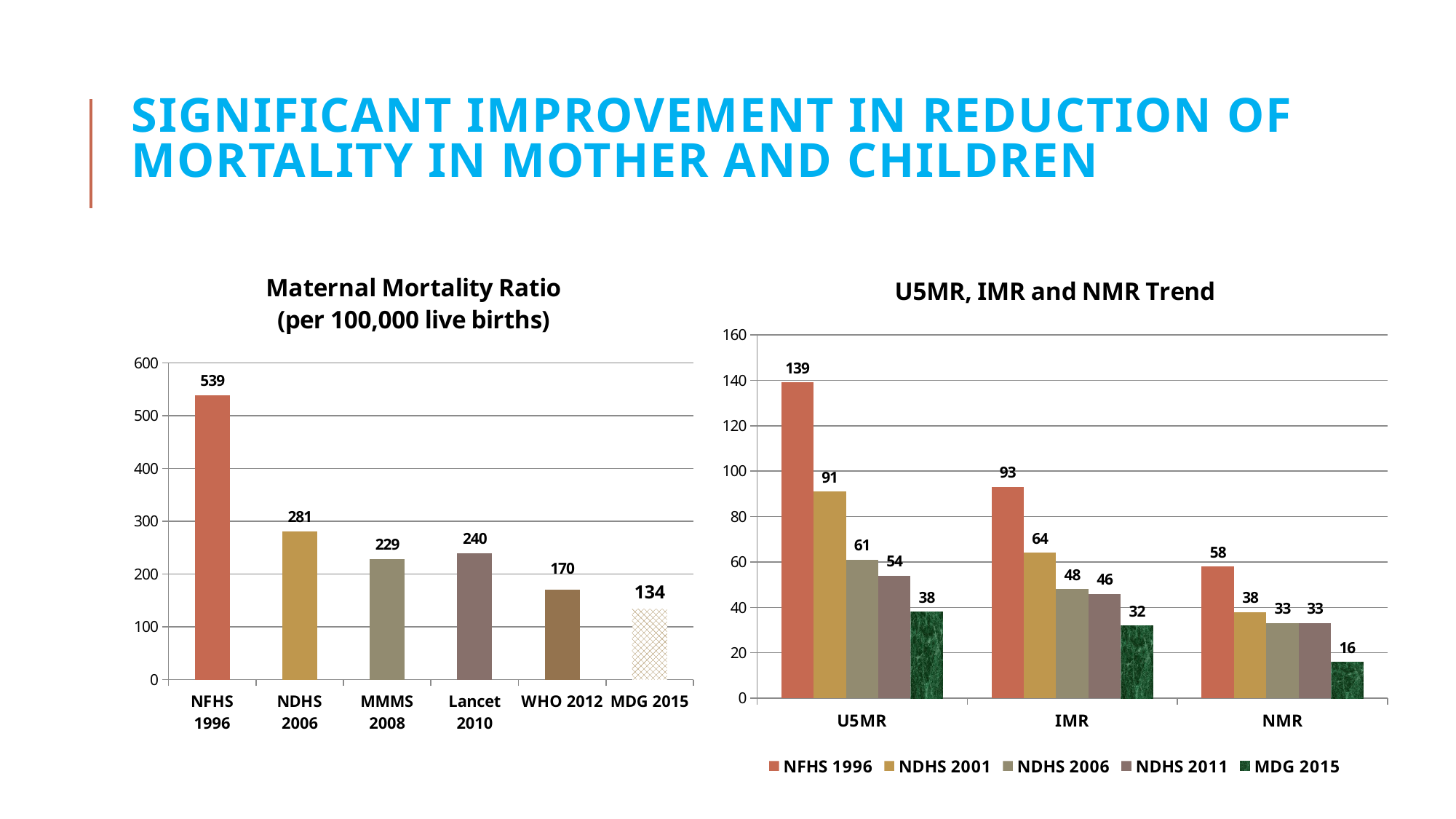
How many series does the legend of the U5MR, IMR and NMR Trend chart list? 5 How many categories are shown in the Maternal Mortality Ratio chart? 6 In the Maternal Mortality Ratio chart, what is the value for NFHS 1996? 539 In the U5MR, IMR and NMR Trend chart, do the U5MR values rise or fall from NFHS 1996 to MDG 2015? Fall In the U5MR, IMR and NMR Trend chart, which series is shown in dark green? MDG 2015 In the Maternal Mortality Ratio chart, which is larger, MMMS 2008 or Lancet 2010? Lancet 2010 In the U5MR, IMR and NMR Trend chart, what is the MDG 2015 value for NMR? 16 In the U5MR, IMR and NMR Trend chart, what is the NDHS 2011 value for IMR? 46 In the Maternal Mortality Ratio chart, what is the difference between the NDHS 2006 and WHO 2012 values? 111 In the Maternal Mortality Ratio chart, which category has the lowest value? MDG 2015 In the U5MR, IMR and NMR Trend chart, what is the difference between the NFHS 1996 and NDHS 2001 values for U5MR? 48 What kind of chart is the Maternal Mortality Ratio chart? Bar chart